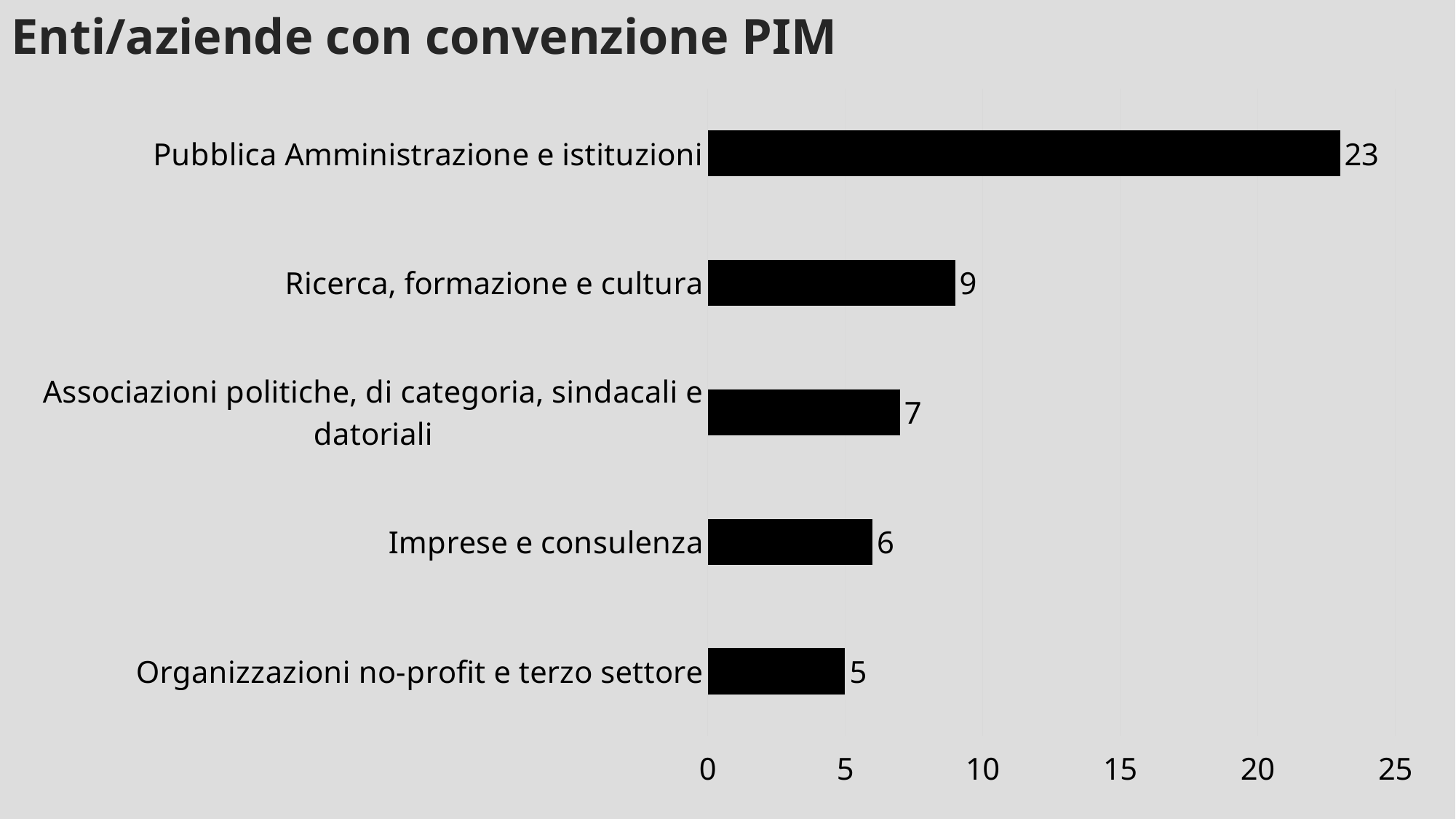
What is the value for Pubblica Amministrazione e istituzioni? 23 Which is larger, the value for Imprese e consulenza or the value for Organizzazioni no-profit e terzo settore? Imprese e consulenza How many categories are shown in the chart? 5 What is the value for Ricerca, formazione e cultura? 9 Which category has the lowest value? Organizzazioni no-profit e terzo settore What is the value for Associazioni politiche, di categoria, sindacali e datoriali? 7 What is the title of the chart? Enti/aziende con convenzione PIM What is the value for Imprese e consulenza? 6 What is the value for Organizzazioni no-profit e terzo settore? 5 Which category has the highest value? Pubblica Amministrazione e istituzioni What is the difference between the values for Pubblica Amministrazione e istituzioni and Ricerca, formazione e cultura? 14 What kind of chart is shown on the slide? Bar chart